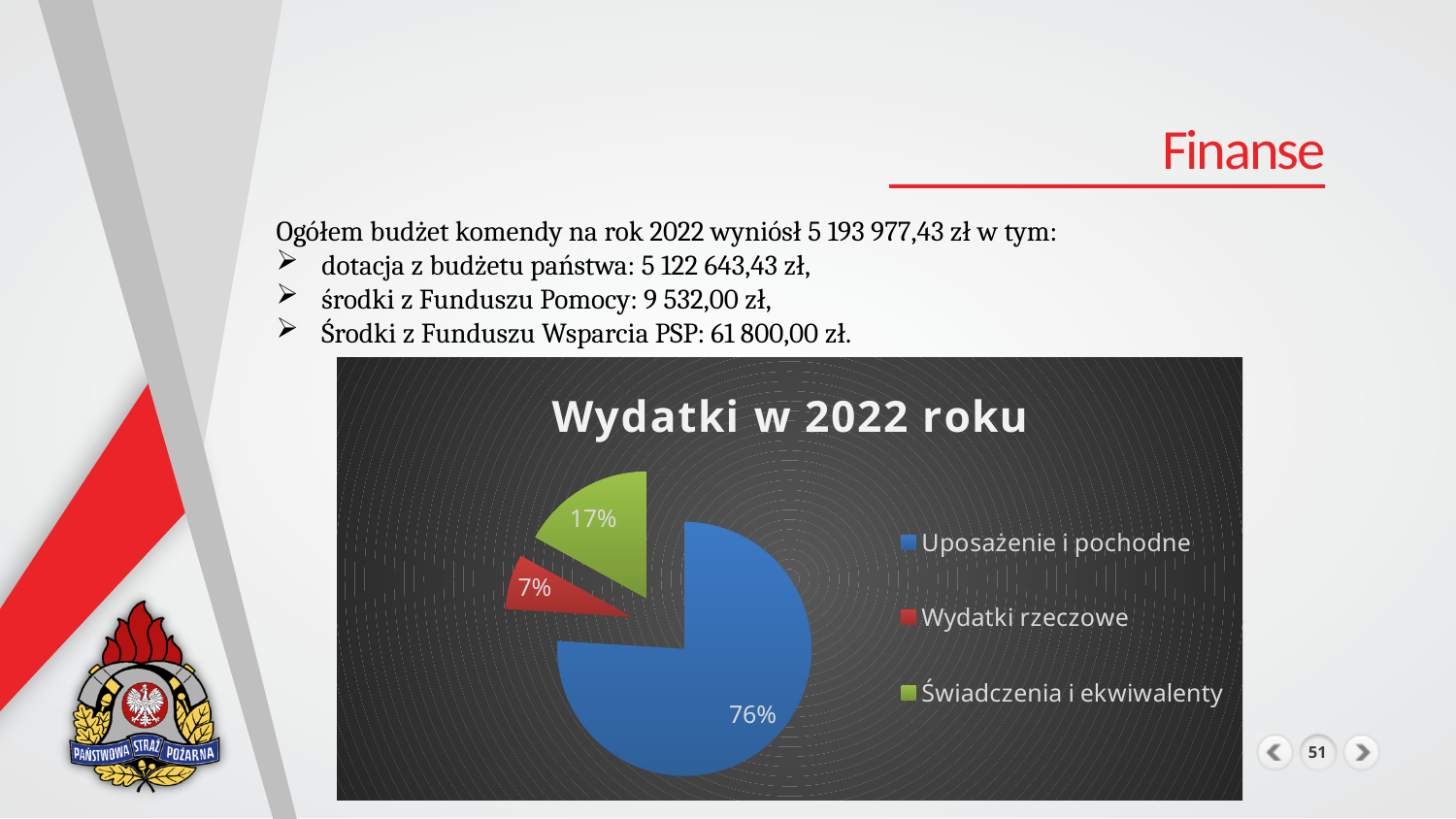
What is the difference in percentage points between Uposażenie i pochodne and Świadczenia i ekwiwalenty? 59 percentage points What is the title of the chart? Wydatki w 2022 roku What colour is the slice for Wydatki rzeczowe? red What kind of chart is shown on the slide? pie chart How many slices does the pie chart have? 3 What share of the pie does Wydatki rzeczowe take? 7% What share of the pie does Uposażenie i pochodne take? 76% Which category has the largest slice of the pie? Uposażenie i pochodne Which category has the smallest slice of the pie? Wydatki rzeczowe How many entries does the legend list? 3 Which is larger, the share for Świadczenia i ekwiwalenty or the share for Wydatki rzeczowe? Świadczenia i ekwiwalenty What share of the pie does Świadczenia i ekwiwalenty take? 17%